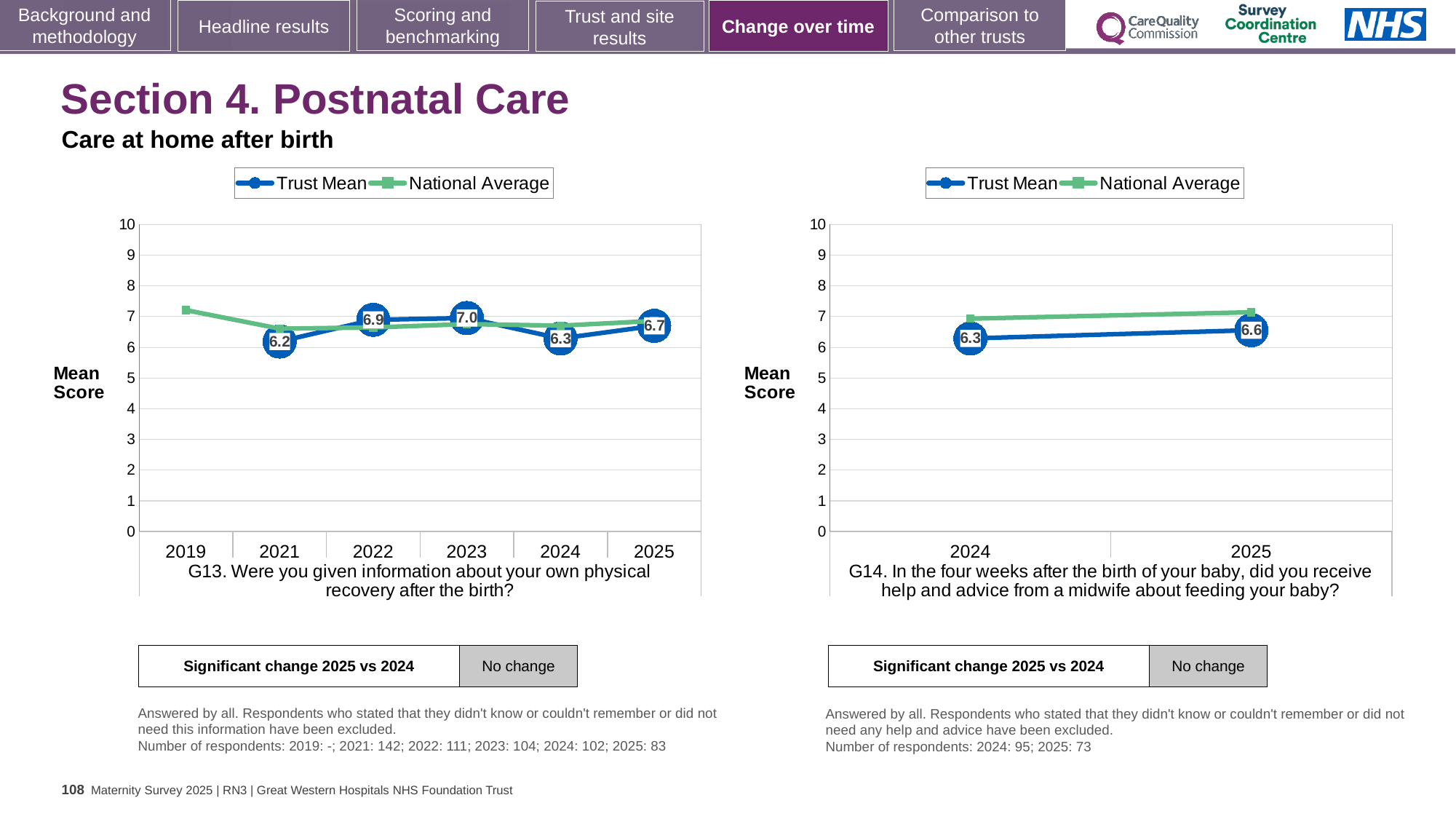
In the G13 chart on the left, is the Trust Mean higher in 2025 or in 2024? 2025 In the G13 chart on the left, what is the difference between the Trust Mean for 2022 and 2024? 0.6 In the G13 chart on the left, which year has the lowest Trust Mean? 2021 In the G13 chart on the left, is the National Average for 2019 greater or less than 7? greater In the G14 chart on the right, does the Trust Mean rise or fall from 2024 to 2025? rise How many series does the legend of the G14 chart on the right list? 2 In the G13 chart on the left, what is the Trust Mean for 2021? 6.2 In the G13 chart on the left, what is the Trust Mean for 2023? 7.0 In the G14 chart on the right, what is the difference between the Trust Mean for 2025 and 2024? 0.3 In the G13 chart on the left, which year has the highest Trust Mean? 2023 In the G13 chart on the left, how many years are shown on the x axis? 6 In the G14 chart on the right, what is the Trust Mean for 2025? 6.6